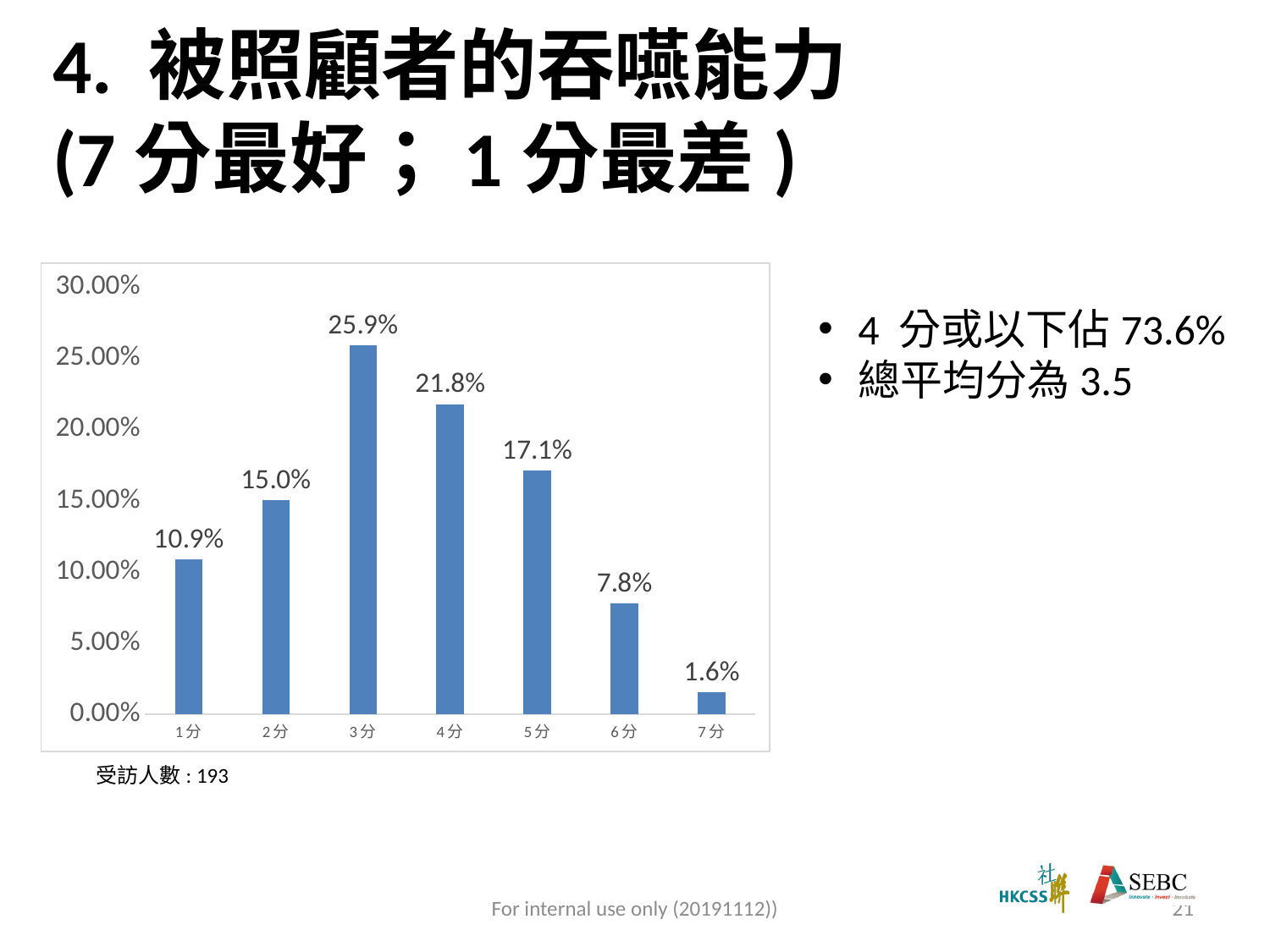
What is the difference between the values for 5分 and 6分? 9.3% Which category has the lowest value? 7分 How many categories are shown on the x axis? 7 Is the value for 4分 greater or less than 20.00%? greater Do the values rise or fall from 3分 to 7分? Fall What is the difference between the values for 3分 and 4分? 4.1% What is the value for 3分? 25.9% Which is larger, the value for 2分 or the value for 5分? 5分 What is the value for 1分? 10.9% What is the value for 7分? 1.6% What kind of chart is shown on the slide? Bar chart Which category has the highest value? 3分